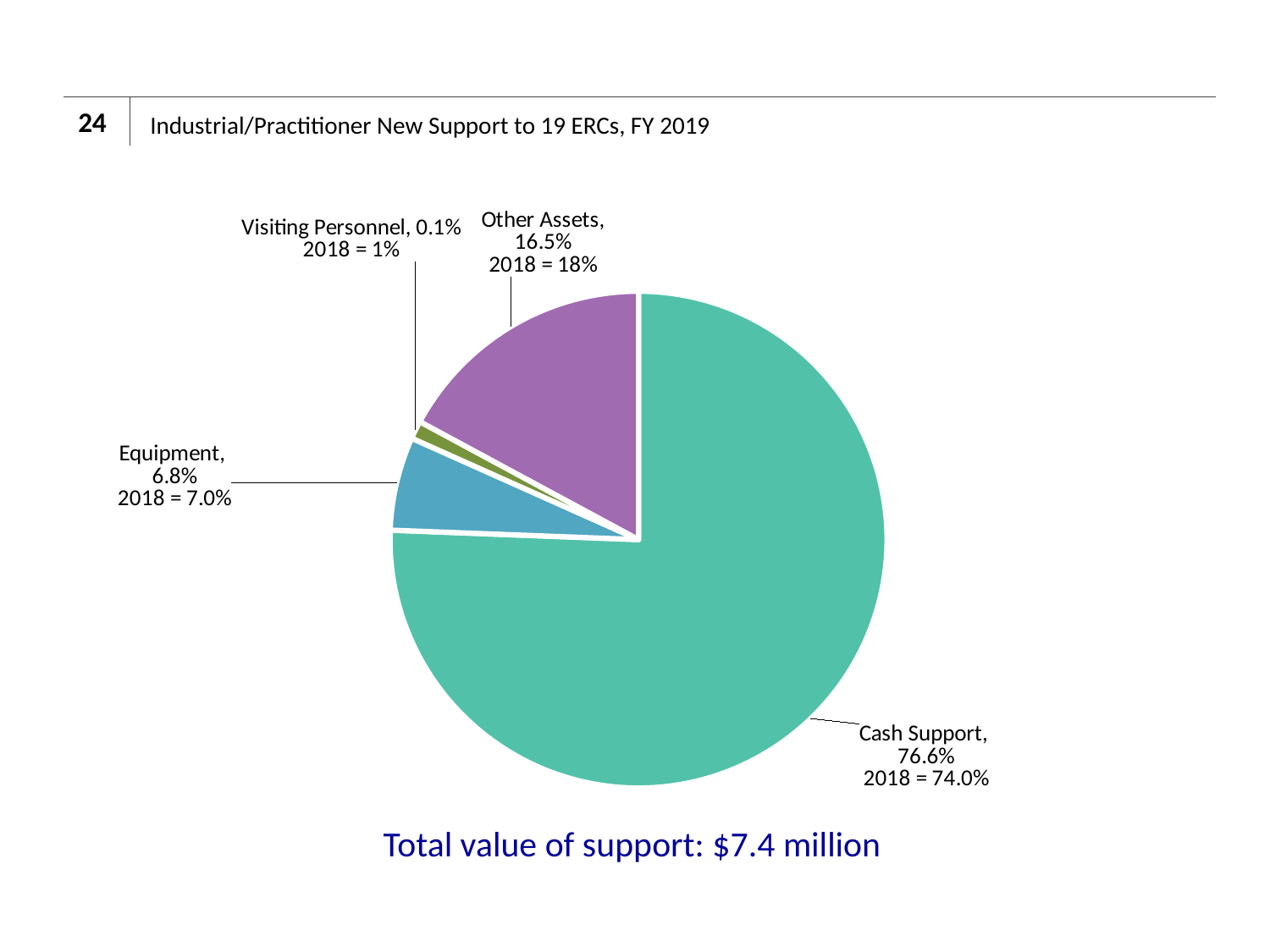
What percentage is shown for Equipment? 6.8% What is the difference in percentage points between Other Assets and Equipment? 9.7 Which is larger, the share for Equipment or the share for Other Assets? Other Assets What was the 2018 percentage for Cash Support according to the label? 74.0% How many slices does the pie chart have? 4 What share of the pie does Cash Support represent? 76.6% What percentage is shown for Other Assets? 16.5% What total value of support is stated below the chart? $7.4 million Which category has the largest slice of the pie? Cash Support What kind of chart is shown on the slide? Pie chart What percentage is shown for Visiting Personnel? 0.1% Which category has the smallest slice of the pie? Visiting Personnel